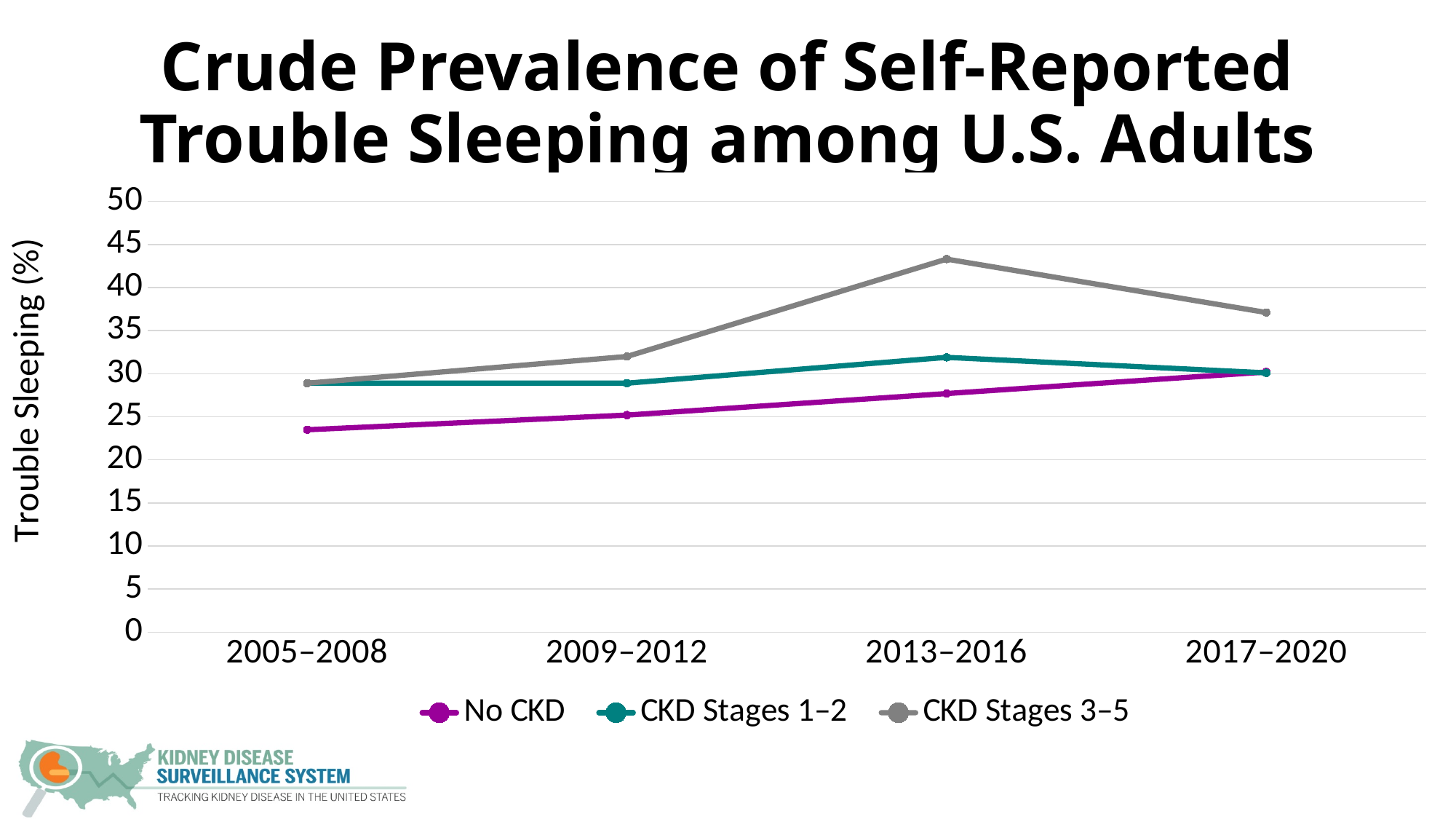
What kind of chart is shown on the slide? Line chart In which period is the value for No CKD lowest? 2005–2008 Does the value for No CKD rise or fall from 2005–2008 to 2017–2020? rise In which period is the value for CKD Stages 3–5 highest? 2013–2016 Is the value for No CKD in 2005–2008 greater or less than 25? less Is the value for CKD Stages 3–5 in 2017–2020 greater or less than 35? greater What is the label on the y axis? Trouble Sleeping (%) In 2013–2016, which is larger: the value for CKD Stages 3–5 or the value for No CKD? CKD Stages 3–5 How many time periods are shown on the x axis? 4 Is the value for CKD Stages 3–5 in 2013–2016 greater or less than 40? greater How many series does the legend list? 3